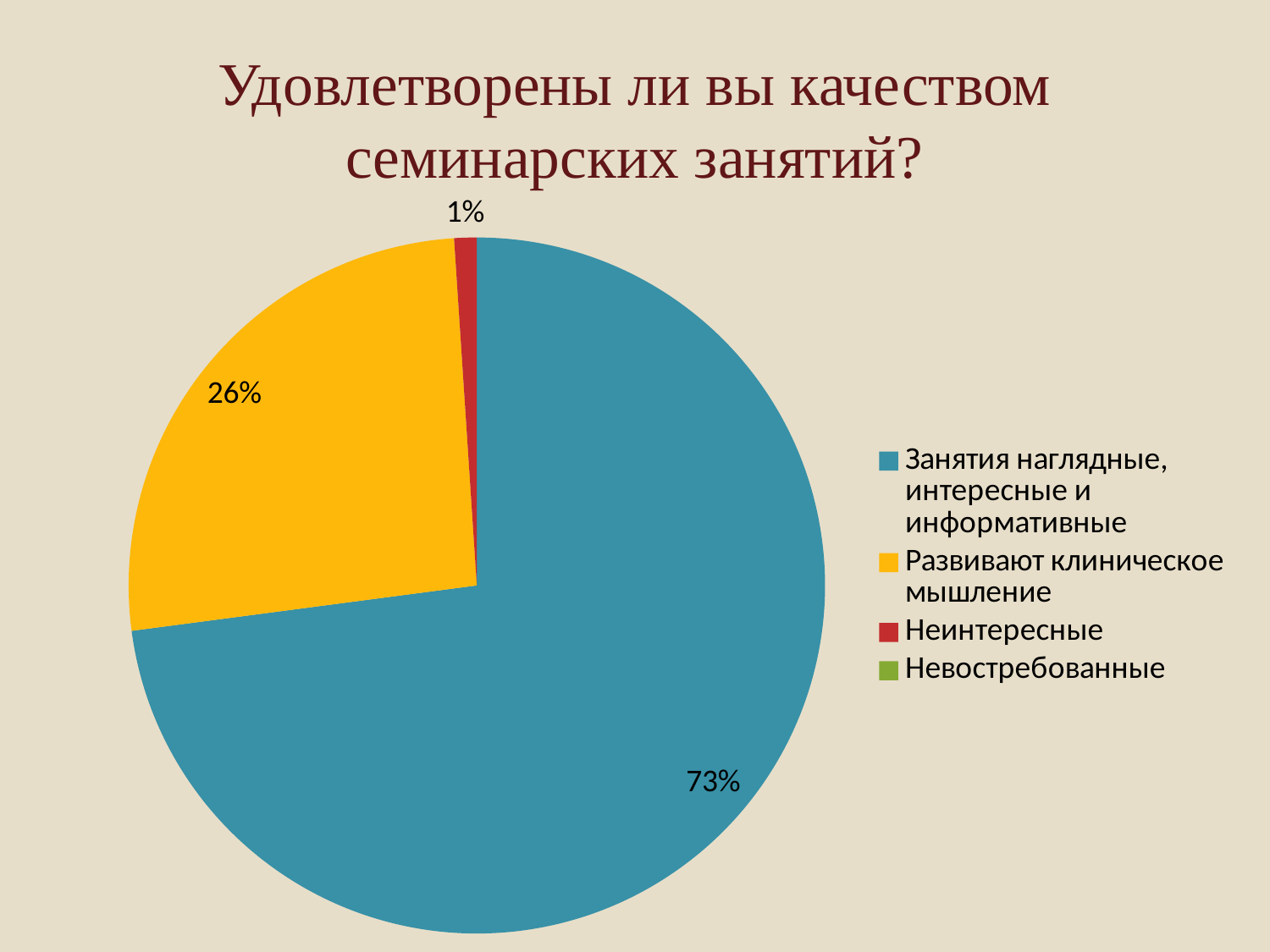
Which is larger: the slice for "Развивают клиническое мышление" or the slice for "Неинтересные"? Развивают клиническое мышление Which category has the largest slice of the pie? Занятия наглядные, интересные и информативные What is the difference in percentage points between the "Занятия наглядные, интересные и информативные" slice and the "Развивают клиническое мышление" slice? 47 What is the title of the chart? Удовлетворены ли вы качеством семинарских занятий? Which labelled slice is the smallest? Неинтересные What share of the pie is labelled for "Развивают клиническое мышление"? 26% How many categories does the legend list? 4 What colour is the slice for "Развивают клиническое мышление"? yellow What share of the pie is labelled for "Занятия наглядные, интересные и информативные"? 73% What is the combined share of the "Развивают клиническое мышление" and "Неинтересные" slices? 27% What kind of chart is shown on the slide? pie chart What share of the pie is labelled for "Неинтересные"? 1%